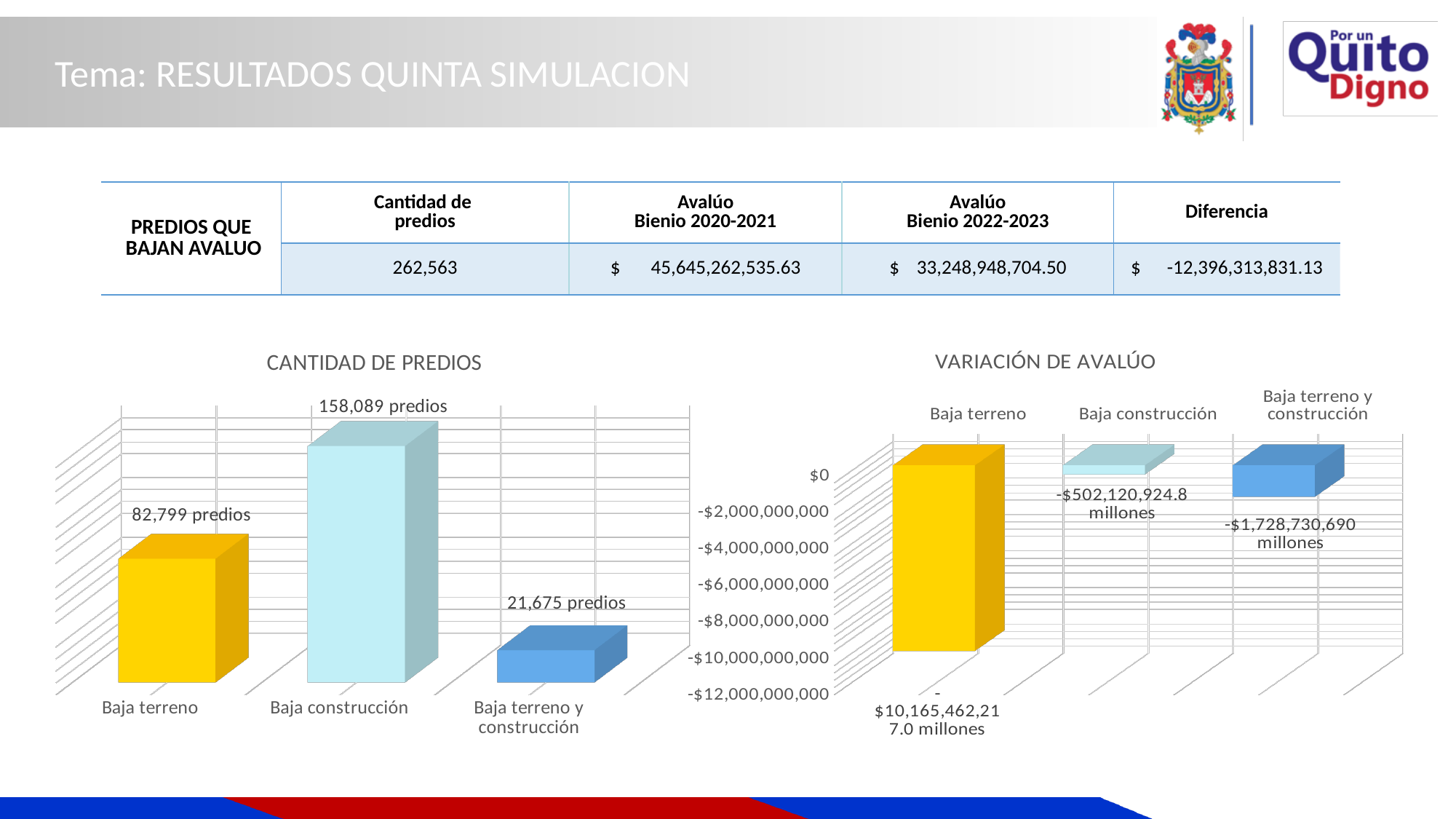
In the CANTIDAD DE PREDIOS chart, what is the value for Baja terreno? 82,799 predios In the CANTIDAD DE PREDIOS chart, what is the value for Baja terreno y construcción? 21,675 predios In the CANTIDAD DE PREDIOS chart, which category has the highest number of predios? Baja construcción In the CANTIDAD DE PREDIOS chart, which category has the lowest number of predios? Baja terreno y construcción In the VARIACIÓN DE AVALÚO chart, what is the value shown for Baja construcción? -$502,120,924.8 millones In the CANTIDAD DE PREDIOS chart, what is the difference between Baja construcción and Baja terreno? 75,290 predios In the CANTIDAD DE PREDIOS chart, how many predios are shown for Baja construcción? 158,089 predios In the CANTIDAD DE PREDIOS chart, how many categories are plotted? 3 What kind of chart is the VARIACIÓN DE AVALÚO chart? Bar chart In the VARIACIÓN DE AVALÚO chart, which is larger in magnitude, Baja construcción or Baja terreno y construcción? Baja terreno y construcción In the VARIACIÓN DE AVALÚO chart, is the value for Baja terreno greater or less than -$8,000,000,000? less In the VARIACIÓN DE AVALÚO chart, which category has the lowest (most negative) value? Baja terreno